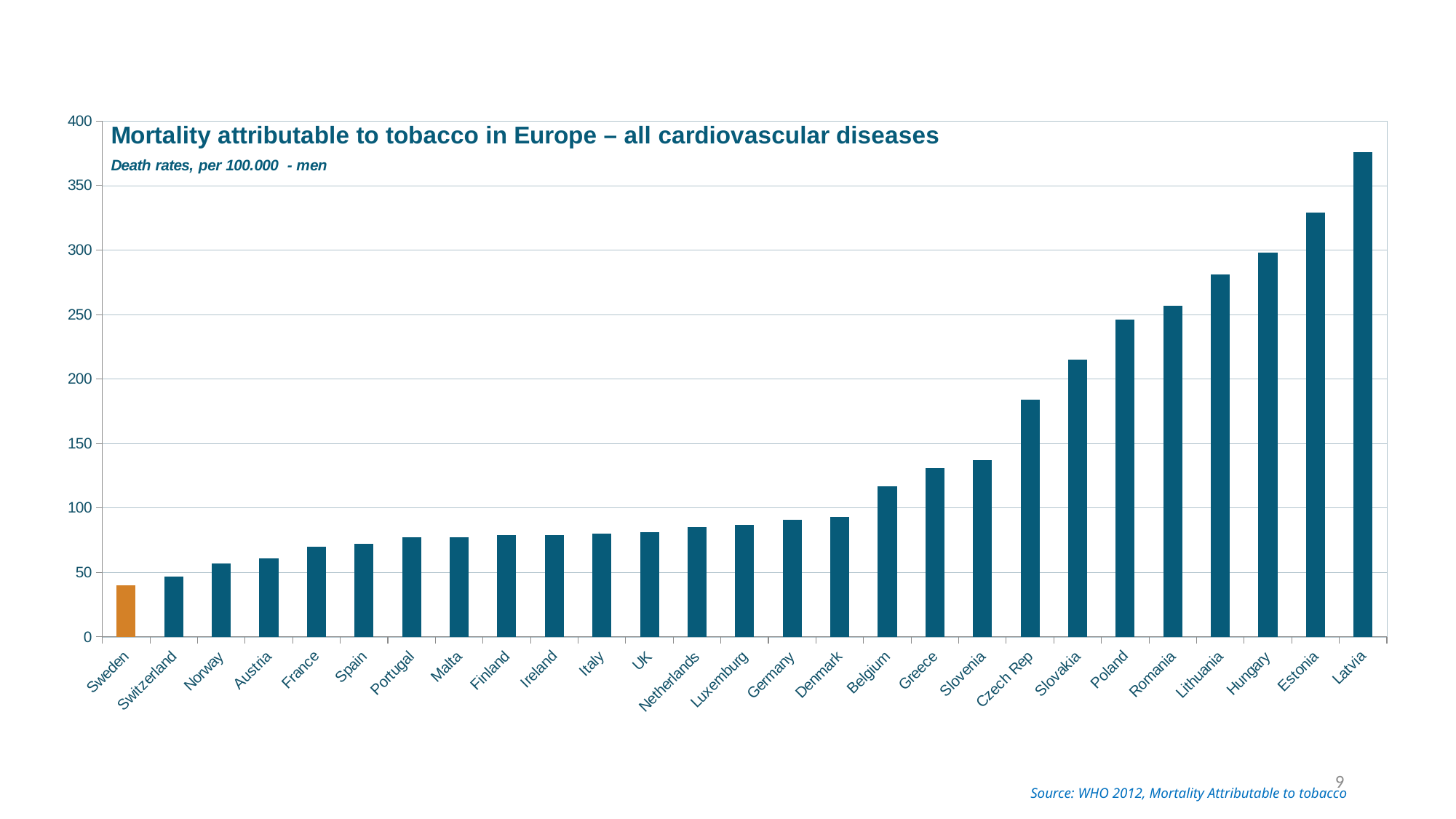
Which country's bar is shown in a different colour (orange) from the others? Sweden How many countries are shown in the chart? 27 Is the value for Sweden greater or less than 50? less Is the value for Latvia greater or less than 350? greater Which country has the lowest death rate in the chart? Sweden Which has a higher death rate, Latvia or Estonia? Latvia Do the values rise or fall from left to right along the x axis? rise Is the value for Estonia greater or less than 300? greater Which country has the highest death rate in the chart? Latvia What kind of chart is shown on the slide? bar chart